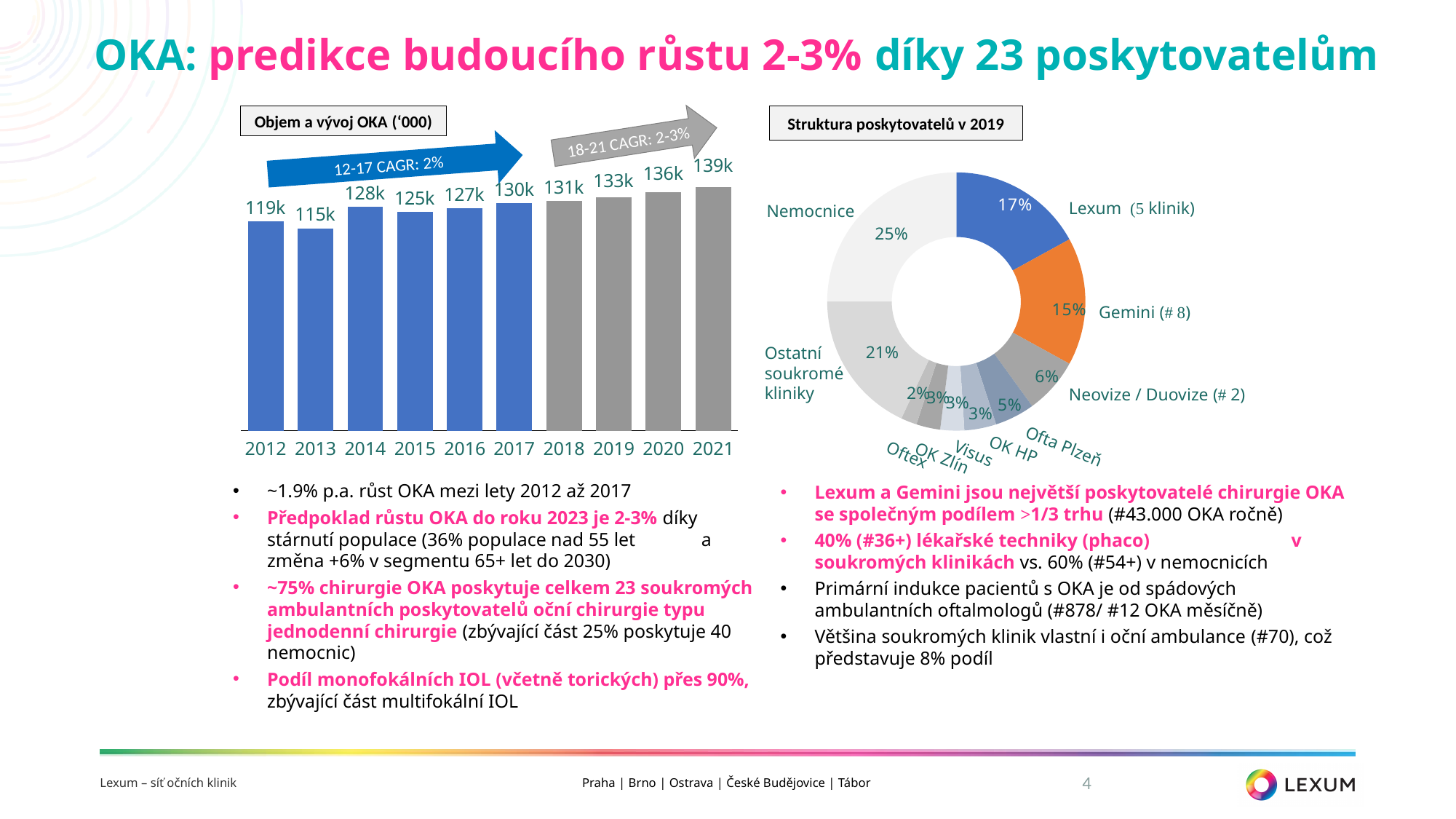
In the chart 'Objem a vývoj OKA ('000)', what is the difference between the values for 2021 and 2012? 20k In the chart 'Struktura poskytovatelů v 2019', what share does Lexum have? 17% In the chart 'Objem a vývoj OKA ('000)', what is the value for 2021? 139k In the chart 'Struktura poskytovatelů v 2019', what share does Nemocnice have? 25% In the chart 'Struktura poskytovatelů v 2019', which segment has the largest share? Nemocnice In the chart 'Objem a vývoj OKA ('000)', is the value for 2014 or 2015 larger? 2014 In the chart 'Objem a vývoj OKA ('000)', which year has the highest value? 2021 In the chart 'Struktura poskytovatelů v 2019', what is the combined share of Lexum and Gemini? 32% What kind of chart is 'Objem a vývoj OKA ('000)'? bar chart In the chart 'Objem a vývoj OKA ('000)', what is the value for 2012? 119k In the chart 'Objem a vývoj OKA ('000)', which year has the lowest value? 2013 How many years are shown on the x axis of the chart 'Objem a vývoj OKA ('000)'? 10